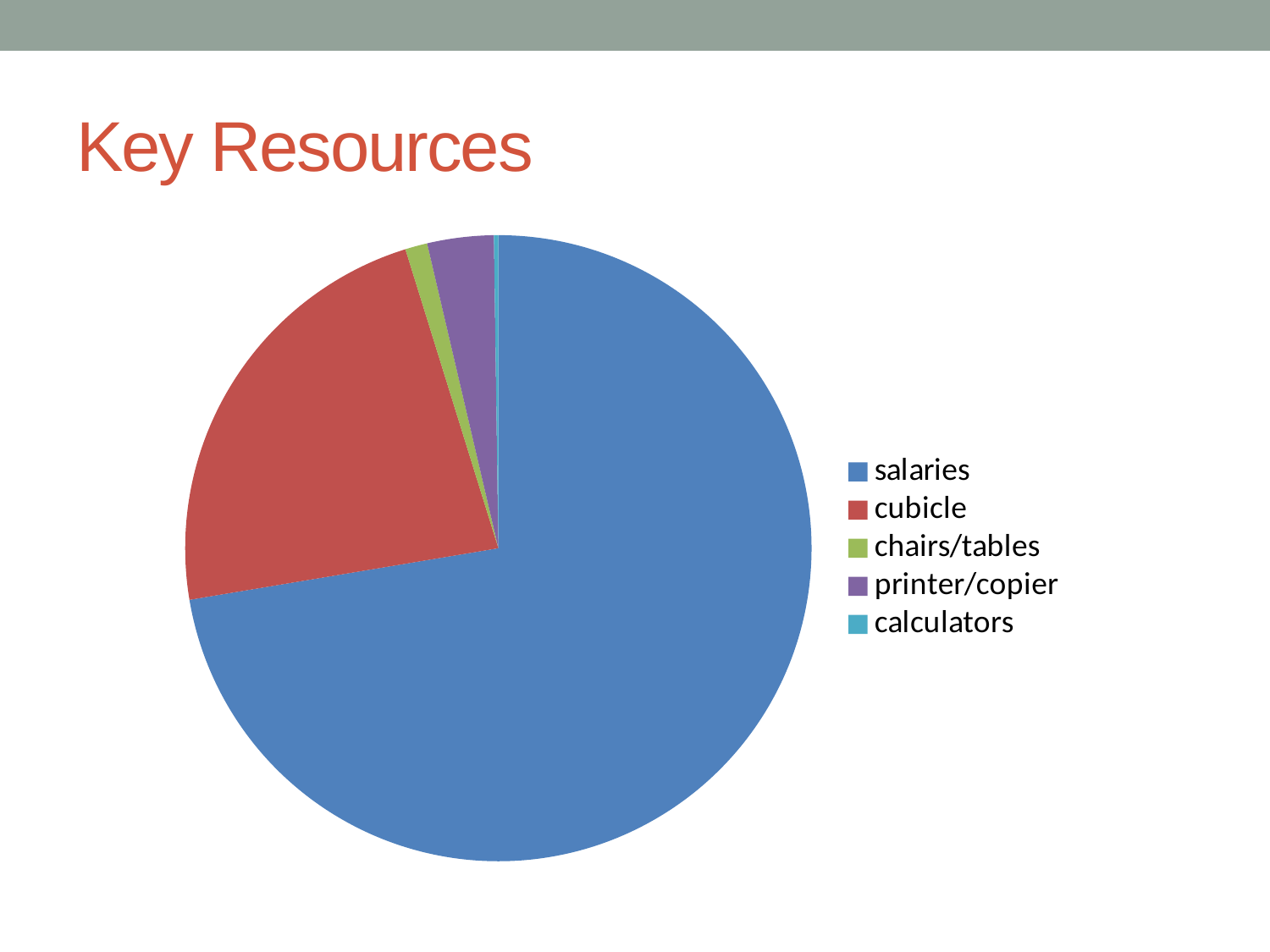
What kind of chart is shown on the slide? pie chart Which slice is larger, cubicle or printer/copier? cubicle How many categories does the pie chart have? 5 Which category has the second-largest slice of the pie chart? cubicle Which slice is larger, printer/copier or chairs/tables? printer/copier What is the title of the slide containing the pie chart? Key Resources Which slice is larger, salaries or cubicle? salaries Which category has the smallest slice of the pie chart? calculators Which category has the largest slice of the pie chart? salaries What colour is the salaries slice in the pie chart? blue